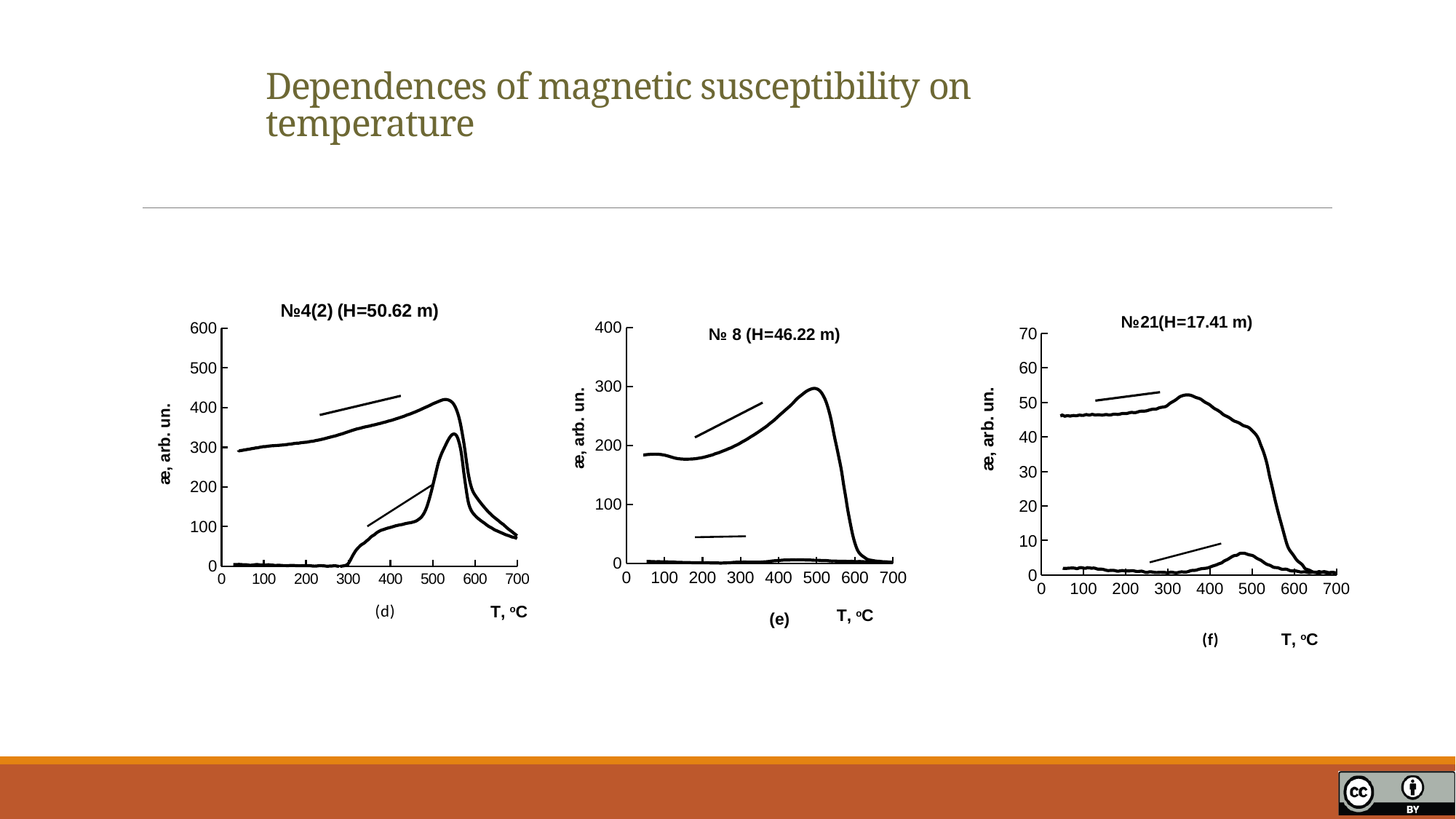
How many charts are shown on the slide? 3 What is the y-axis label on the rightmost chart №21(H=17.41 m)? æ, arb. un. In the rightmost chart №21(H=17.41 m), is the value of the upper curve at 100 °C greater or less than 40? greater What kind of chart is the leftmost chart titled №4(2) (H=50.62 m)? line chart In the middle chart № 8 (H=46.22 m), does the upper curve rise or fall between 500 °C and 600 °C? fall In the leftmost chart №4(2) (H=50.62 m), is the value of the upper curve at 100 °C greater or less than 200? greater In the rightmost chart №21(H=17.41 m), is the peak value of the lower curve greater or less than 20? less In the middle chart № 8 (H=46.22 m), does the upper curve rise or fall between 200 °C and 500 °C? rise What is the title of the middle chart? № 8 (H=46.22 m) In the rightmost chart №21(H=17.41 m), does the upper curve rise or fall between 500 °C and 600 °C? fall